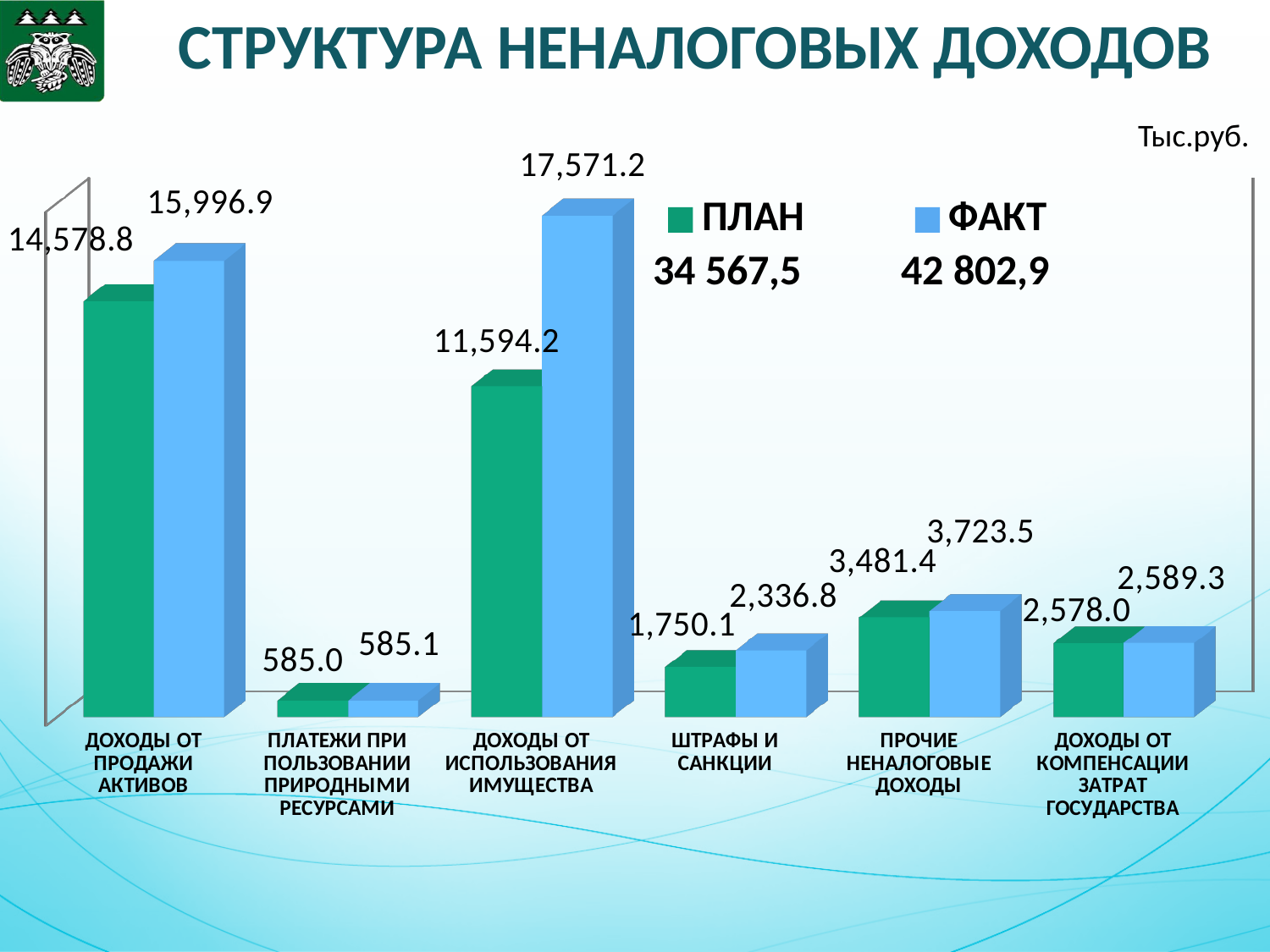
Which is larger for ДОХОДЫ ОТ ПРОДАЖИ АКТИВОВ, the ПЛАН value or the ФАКТ value? ФАКТ What is the ФАКТ value for ПРОЧИЕ НЕНАЛОГОВЫЕ ДОХОДЫ? 3,723.5 What is the ПЛАН value for ДОХОДЫ ОТ ПРОДАЖИ АКТИВОВ? 14,578.8 What is the ПЛАН value for ШТРАФЫ И САНКЦИИ? 1,750.1 What is the difference between the ФАКТ and ПЛАН values for ШТРАФЫ И САНКЦИИ? 586.7 Which category has the lowest ПЛАН value? ПЛАТЕЖИ ПРИ ПОЛЬЗОВАНИИ ПРИРОДНЫМИ РЕСУРСАМИ What kind of chart is shown on the slide? Bar chart How many categories are shown on the x axis? 6 How many series does the legend list? 2 What is the ФАКТ value for ДОХОДЫ ОТ ИСПОЛЬЗОВАНИЯ ИМУЩЕСТВА? 17,571.2 What is the difference between the ФАКТ and ПЛАН values for ДОХОДЫ ОТ ИСПОЛЬЗОВАНИЯ ИМУЩЕСТВА? 5,977.0 Which category has the highest ФАКТ value? ДОХОДЫ ОТ ИСПОЛЬЗОВАНИЯ ИМУЩЕСТВА